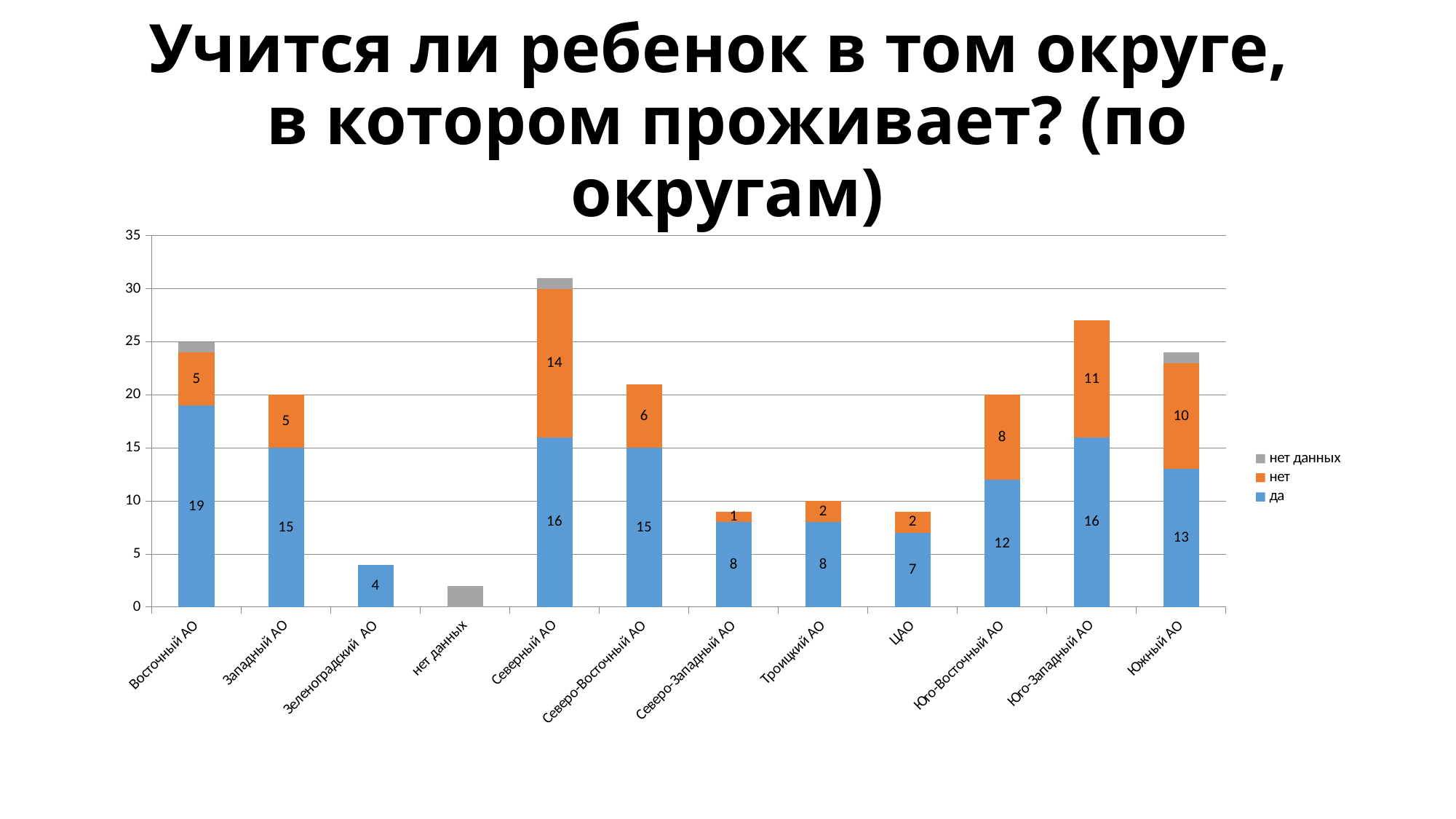
What is the difference between the "нет" values for Северный АО and Юго-Западный АО? 3 What is the value of the "да" series for Восточный АО? 19 Which category has the lowest value for the "нет" series? Северо-Западный АО Which is larger: the "да" value for Юго-Восточный АО or the "да" value for Южный АО? Южный АО Which series is shown in orange in the legend? нет Is the total height of the bar for Северный АО greater or less than 30? greater How many categories are shown on the x axis? 12 What is the total of the stacked bar for Юго-Западный АО? 27 How many series does the legend list? 3 What type of chart is shown on the slide? Stacked bar chart Which category has the highest value for the "да" series? Восточный АО What is the value of the "нет" series for Северный АО? 14